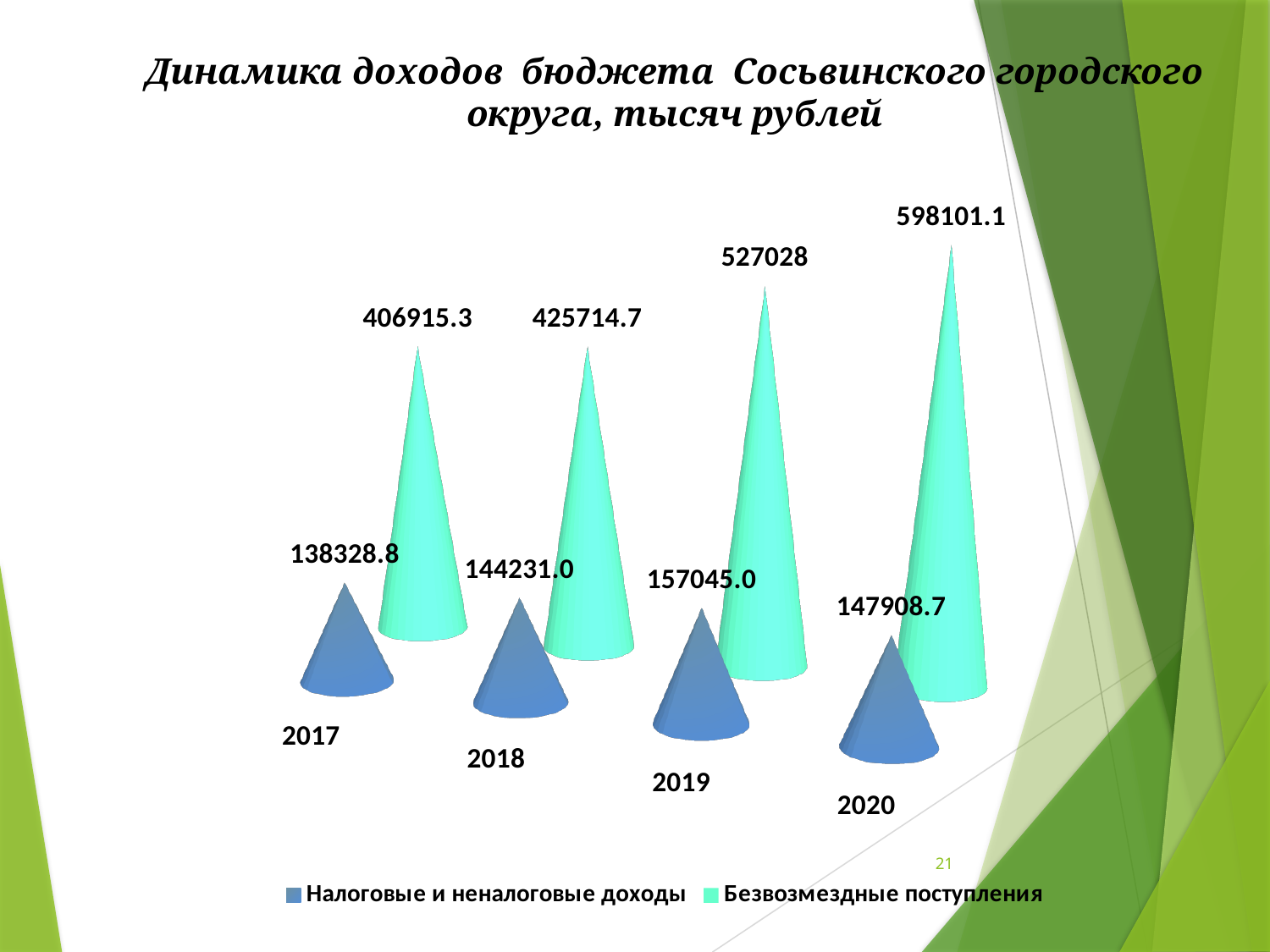
What is the difference between Безвозмездные поступления in 2020 and in 2019? 71073.1 What is the value of Налоговые и неналоговые доходы for 2017? 138328.8 In which year is Безвозмездные поступления highest? 2020 What is the difference between Налоговые и неналоговые доходы in 2019 and in 2018? 12814.0 How many years are shown on the x axis? 4 What is the value of Безвозмездные поступления for 2020? 598101.1 What is the value of Налоговые и неналоговые доходы for 2020? 147908.7 In which year is Налоговые и неналоговые доходы lowest? 2017 What is the value of Безвозмездные поступления for 2019? 527028 How many series does the legend list? 2 Which is larger in 2018: Налоговые и неналоговые доходы or Безвозмездные поступления? Безвозмездные поступления In which year is Налоговые и неналоговые доходы highest? 2019